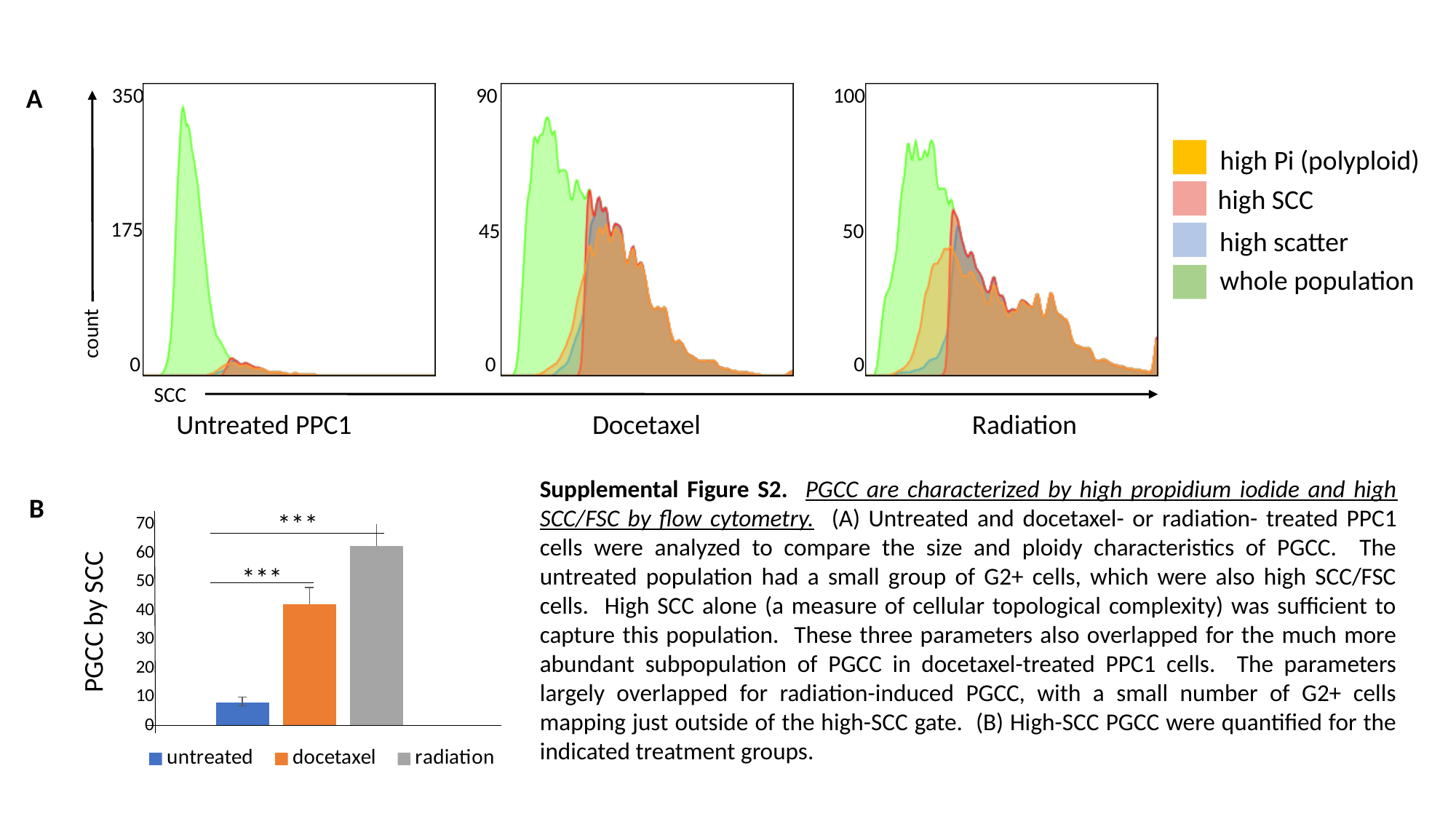
In panel B, is the value for radiation greater or less than 50? greater In panel B, what kind of chart is shown? bar chart In panel B, how many bars are plotted? 3 In panel A, what is the top y-axis tick value on the Untreated PPC1 histogram? 350 In panel B, which is larger, the value for docetaxel or the value for radiation? radiation In panel B, how many entries does the legend list? 3 In panel B, what is the label on the y axis? PGCC by SCC In panel B, which treatment group has the lowest PGCC by SCC? untreated In panel B, is the value for docetaxel greater or less than 30? greater In panel B, is the value for untreated greater or less than 10? less In panel A, how many entries does the legend list? 4 In panel B, which treatment group has the highest PGCC by SCC? radiation